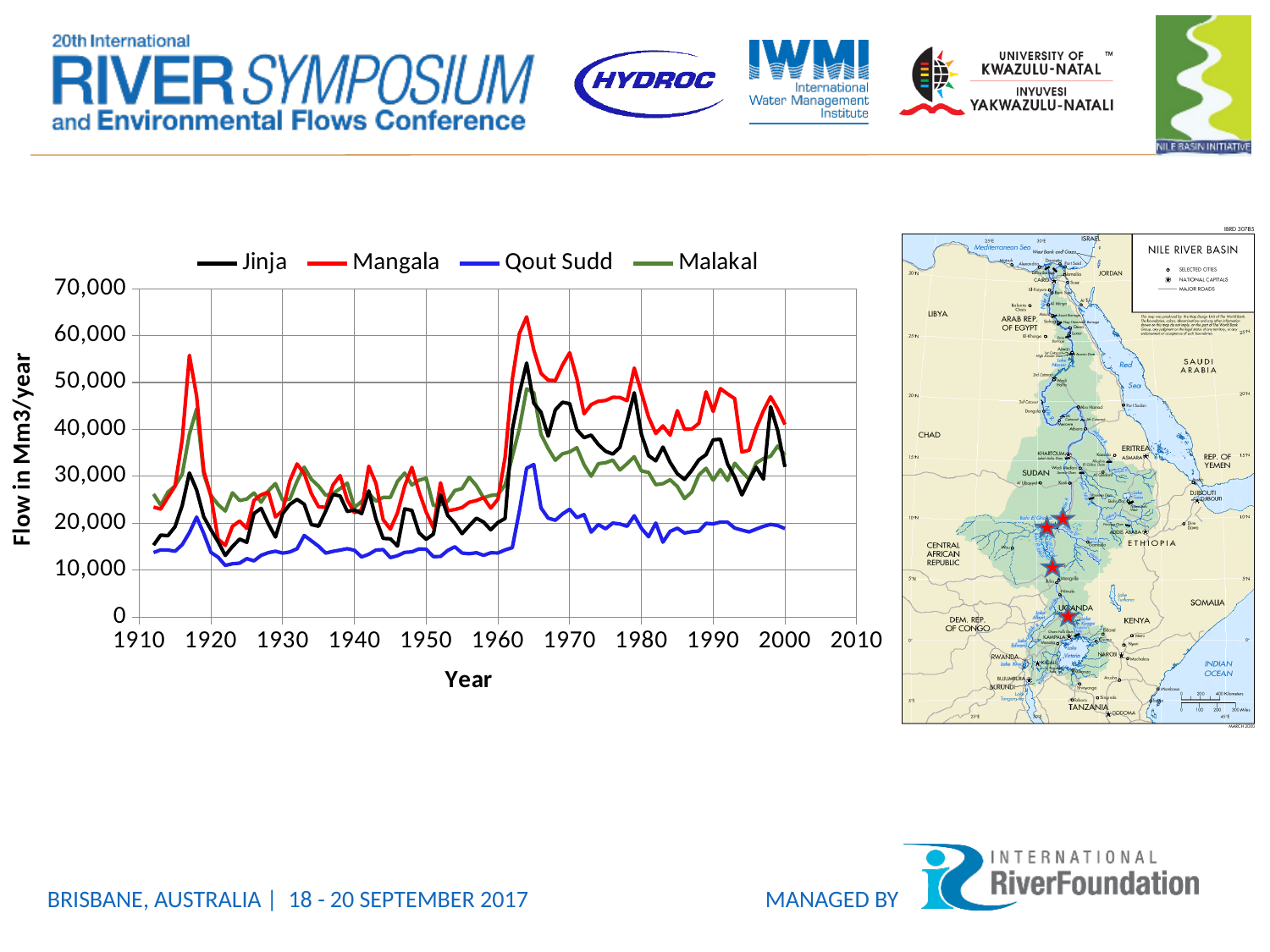
In 1970, which series has the larger flow, Mangala or Qout Sudd? Mangala Which colour is used for the Qout Sudd series in the chart? blue What is the title of the vertical axis of the chart? Flow in Mm3/year Which series has the lowest flow values across most of the period shown? Qout Sudd Is the value for Jinja at its peak around 1964 greater or less than 50,000? greater Is the value for Qout Sudd in 1950 greater or less than 20,000? less What kind of chart is shown on the slide? line chart How many series does the chart's legend list? 4 Does the Qout Sudd series rise or fall between 1960 and 1965? rise Is the peak value of the Mangala series around 1964 greater or less than 60,000? greater Which series reaches the highest flow value in the chart? Mangala